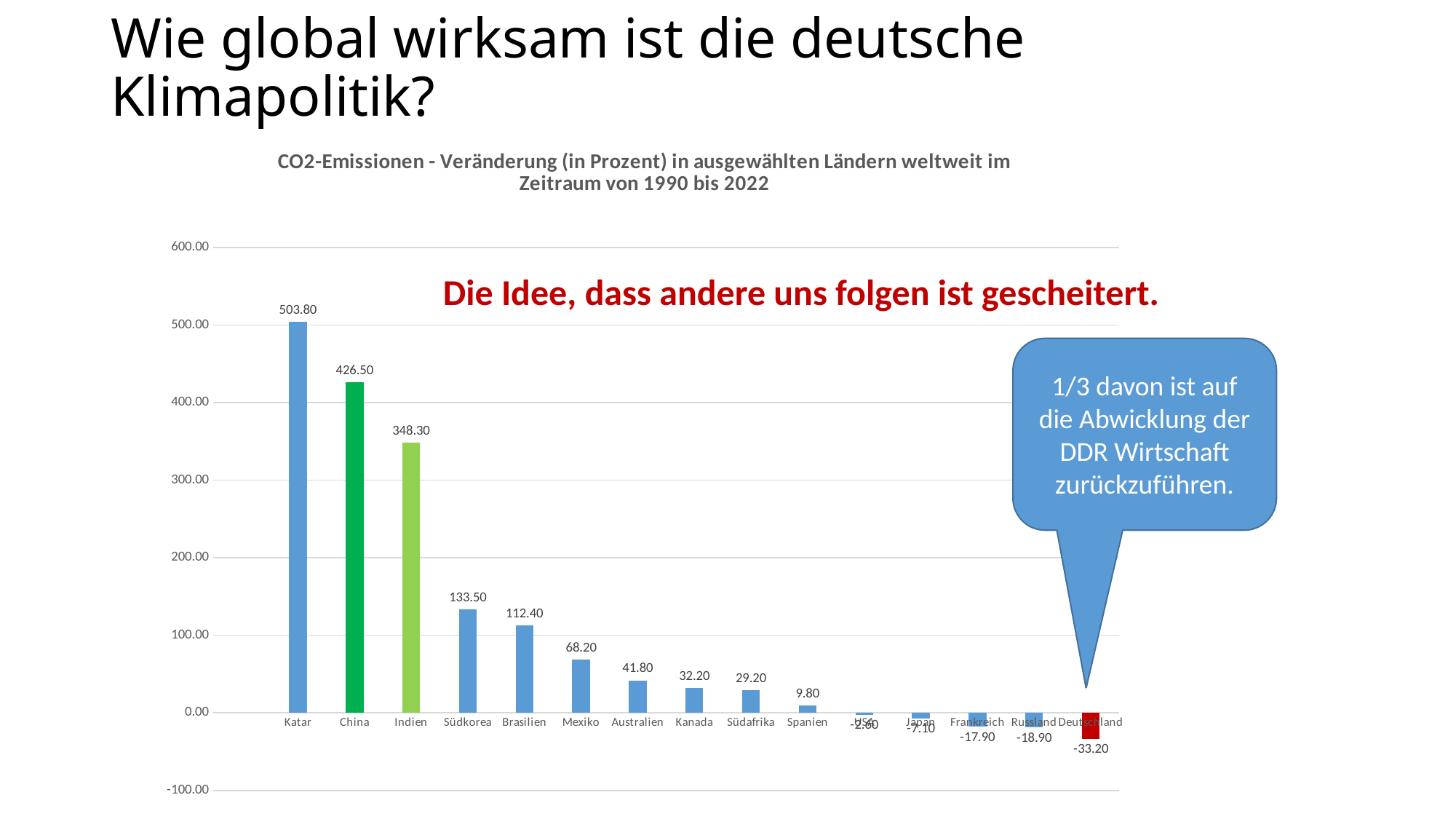
What is the difference between the values for China and Indien? 78.20 How many countries are shown in the chart? 15 Which has a larger value, Brasilien or Mexiko? Brasilien What is the value shown for Russland? -18.90 What type of chart is shown on the slide? Bar chart Which country has the highest value in the chart? Katar What is the title of the chart? CO2-Emissionen - Veränderung (in Prozent) in ausgewählten Ländern weltweit im Zeitraum von 1990 bis 2022 Which country has the lowest value in the chart? Deutschland What is the value shown for Südkorea? 133.50 What is the value shown for Katar? 503.80 Do the values generally rise or fall from left to right along the x axis? Fall What is the value shown for Deutschland? -33.20